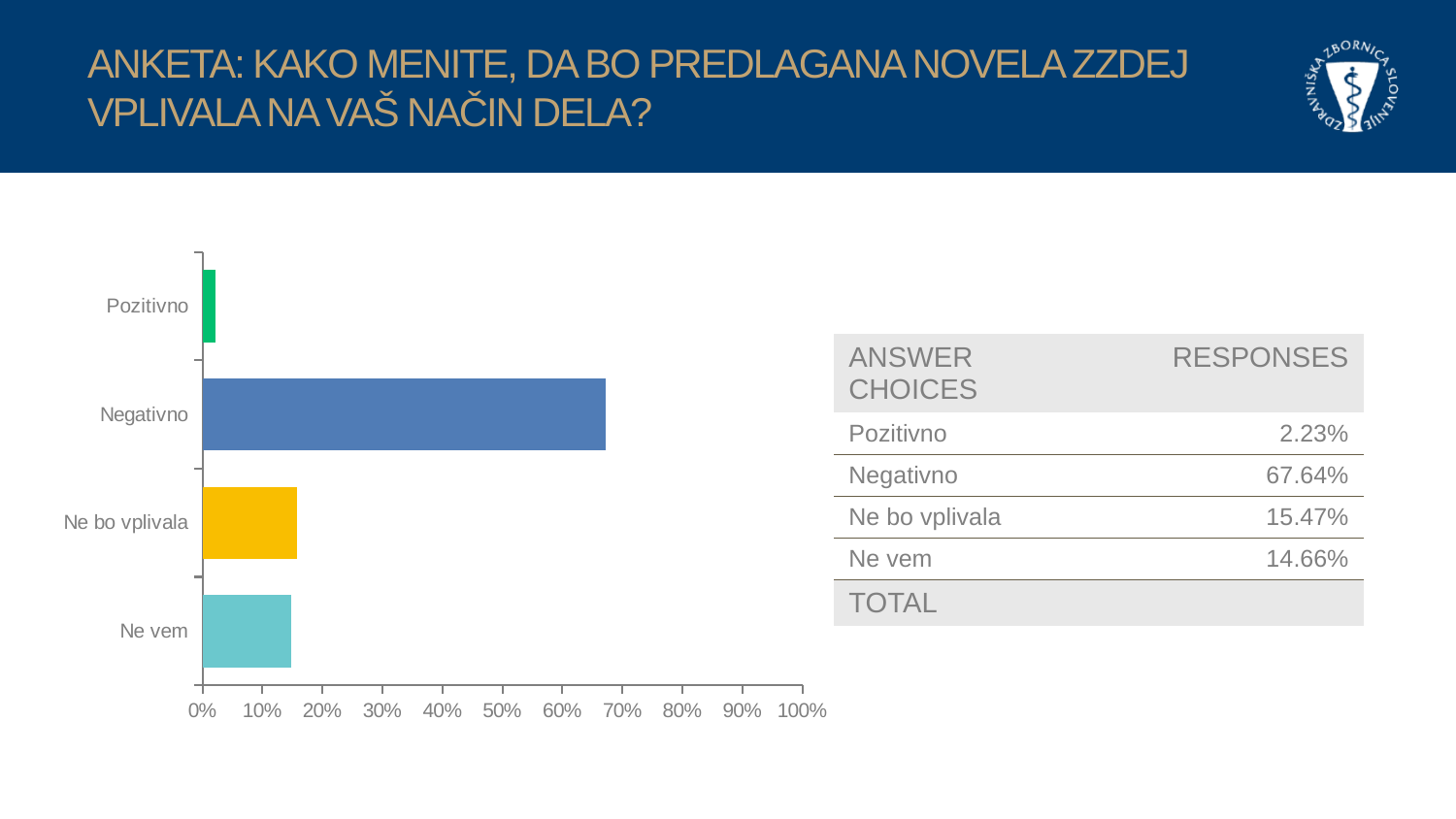
What kind of chart is shown on the slide? bar chart Is the value for Negativno greater or less than 60%? greater Which is larger, the value for Negativno or the value for Ne bo vplivala? Negativno Which category has the highest value in the bar chart? Negativno What is the response share for Ne bo vplivala? 15.47% How many categories does the bar chart show? 4 What is the response share for Negativno? 67.64% Is the value for Ne vem greater or less than 20%? less What is the difference between the values for Negativno and Pozitivno? 65.41% What is the response share for Pozitivno? 2.23% Which category has the lowest value in the bar chart? Pozitivno What is the response share for Ne vem? 14.66%